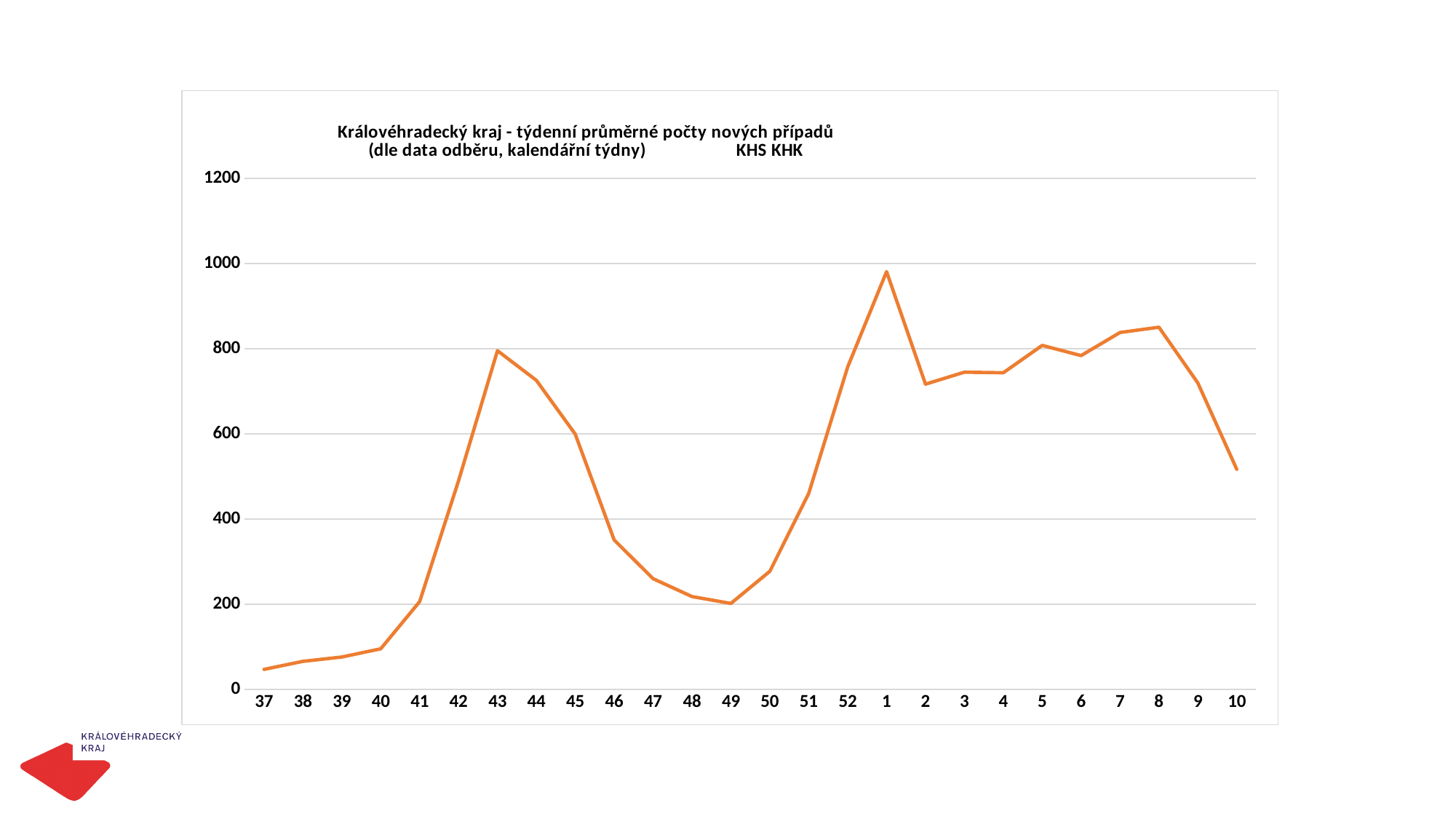
What kind of chart is shown on the slide? line chart Is the value for week 1 greater or less than 800? greater Is the value for week 49 greater or less than 400? less Which week has the highest weekly average number of new cases? 1 Which week has the larger value, week 8 or week 2? 8 How many weeks (data points) are plotted along the x axis? 26 Is the value for week 10 greater or less than 600? less Do the values rise or fall from week 8 to week 10? fall What is the first line of the chart title? Královéhradecký kraj - týdenní průměrné počty nových případů Which week has the lowest weekly average number of new cases? 37 Which week has the larger value, week 43 or week 46? 43